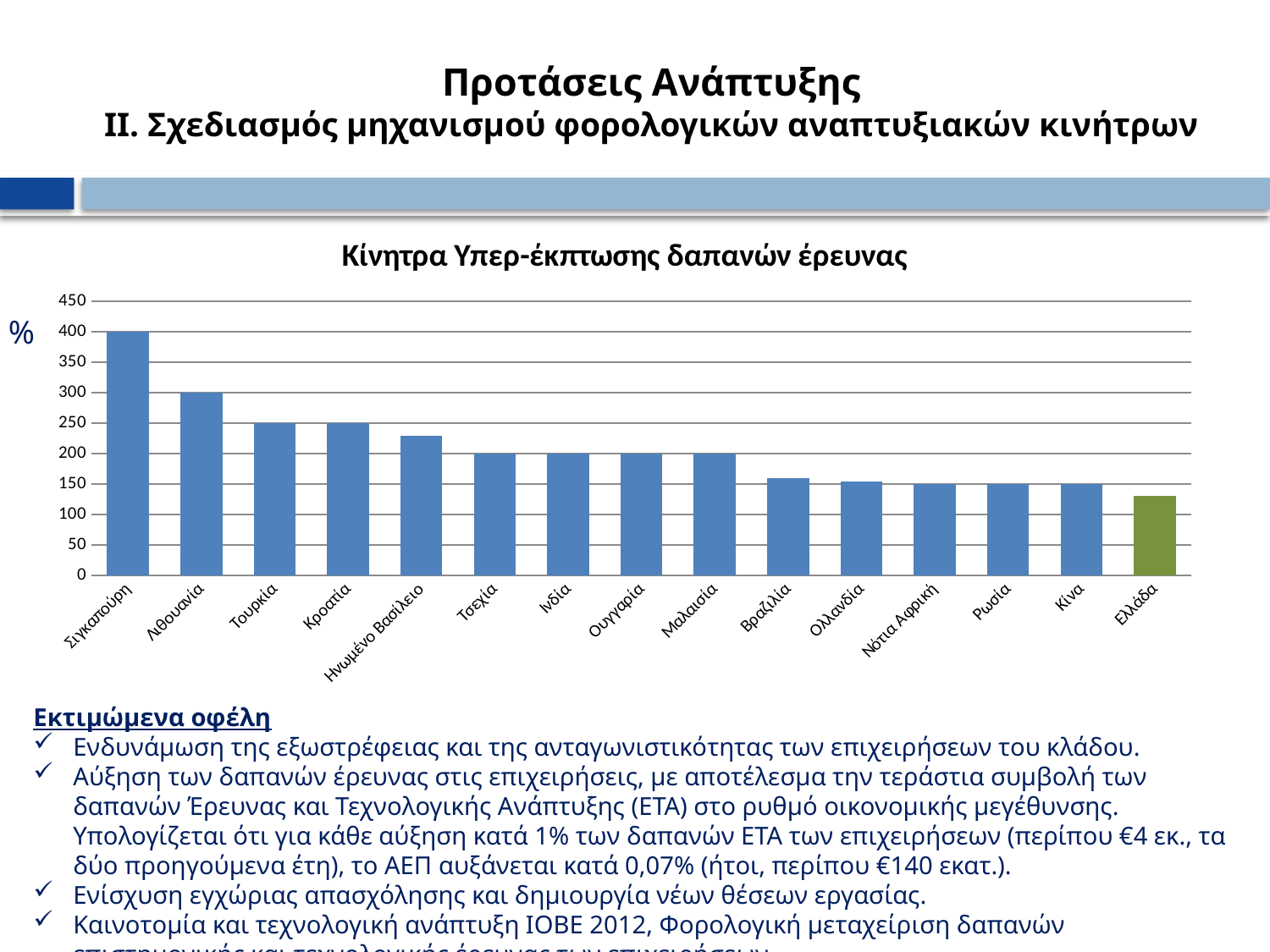
Which country has the highest value in the chart? Σιγκαπούρη Which country has the lowest value in the chart? Ελλάδα What is the difference between the values for Σιγκαπούρη and Λιθουανία? 100 What kind of chart is shown on the slide? bar chart Is the value for Ηνωμένο Βασίλειο greater or less than 200? greater What is the value for Σιγκαπούρη? 400 Is the value for Ελλάδα greater or less than 150? less Do the values rise or fall moving from left to right along the x axis? fall What is the title of the chart? Κίνητρα Υπερ-έκπτωσης δαπανών έρευνας How many countries are shown on the x axis of the chart? 15 What is the value for Λιθουανία? 300 Which is larger, the value for Λιθουανία or the value for Τουρκία? Λιθουανία